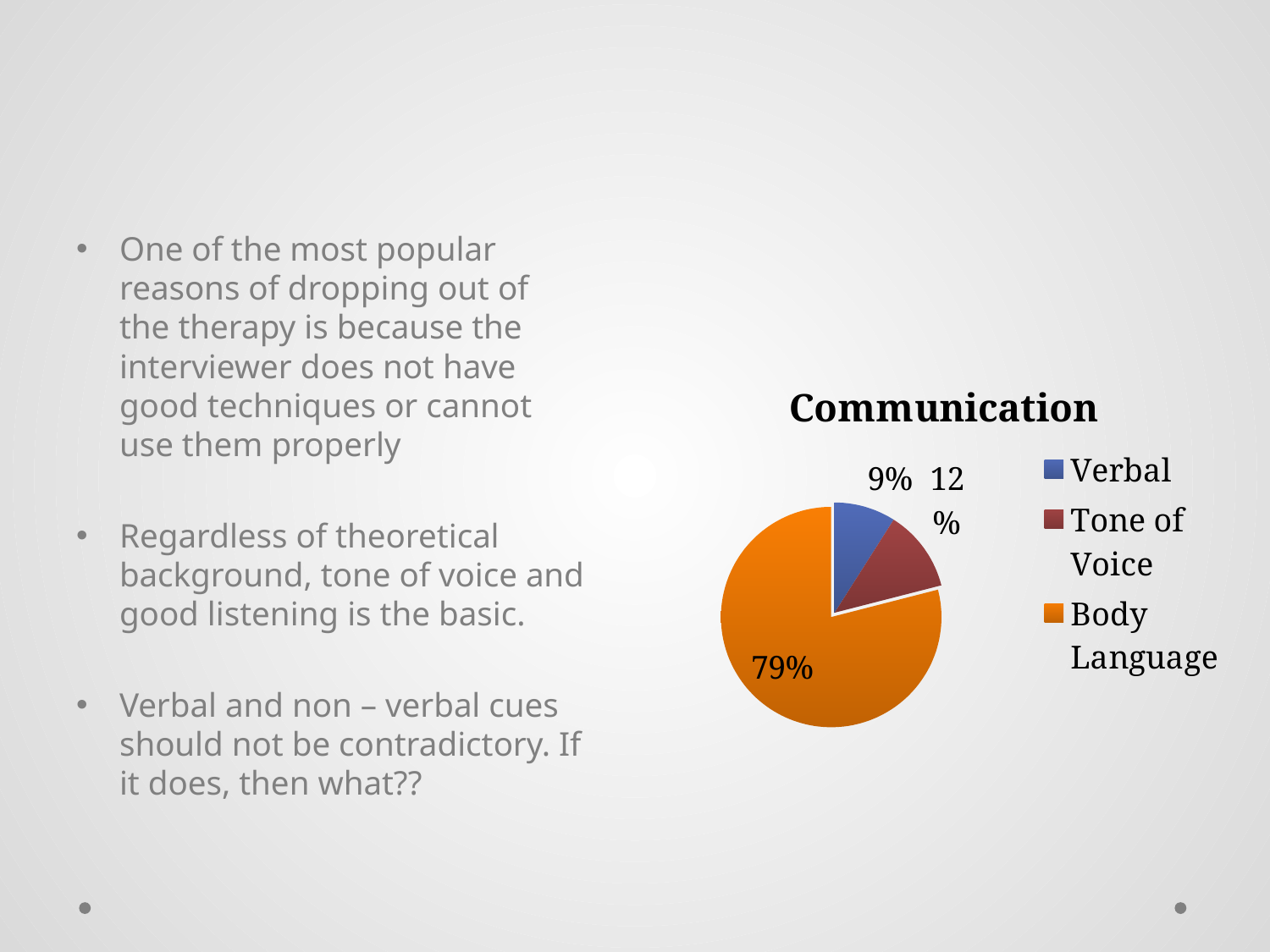
What is the difference between the Body Language share and the Tone of Voice share? 67% What percentage of the pie is Body Language? 79% What type of chart is shown on the slide? pie chart Which category has the smallest share of the pie? Verbal What percentage of the pie is Tone of Voice? 12% What percentage of the pie is Verbal? 9% What is the title of the chart? Communication What colour represents Body Language in the chart? orange What is the combined share of Verbal and Tone of Voice? 21% How many categories does the legend list? 3 Which category has the largest share of the pie? Body Language Which is larger, the share for Tone of Voice or the share for Verbal? Tone of Voice